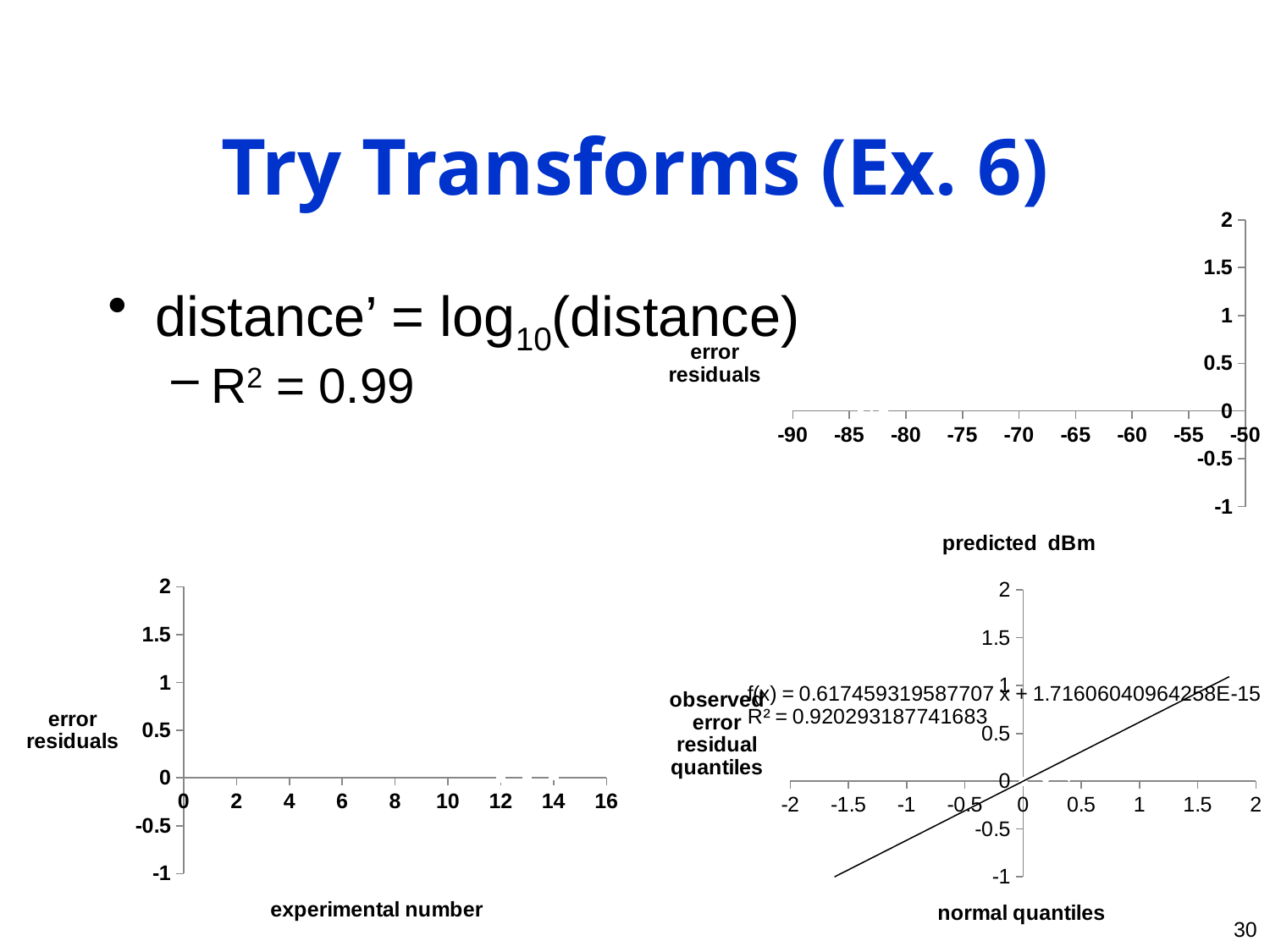
What is the x-axis label of the top-right chart? predicted dBm On the bottom-right chart (normal quantiles), what is the intercept in the printed fitted equation f(x)? 1.71606040964258E-15 On the bottom-right chart (normal quantiles), what is the slope in the printed fitted equation f(x)? 0.617459319587707 What is the x-axis label of the bottom-left chart? experimental number What kind of chart is the bottom-right chart with the fitted line? scatter chart What kind of chart is the top-right chart plotted against predicted dBm? scatter chart On the bottom-right chart (normal quantiles), what R² value is printed on the chart? 0.920293187741683